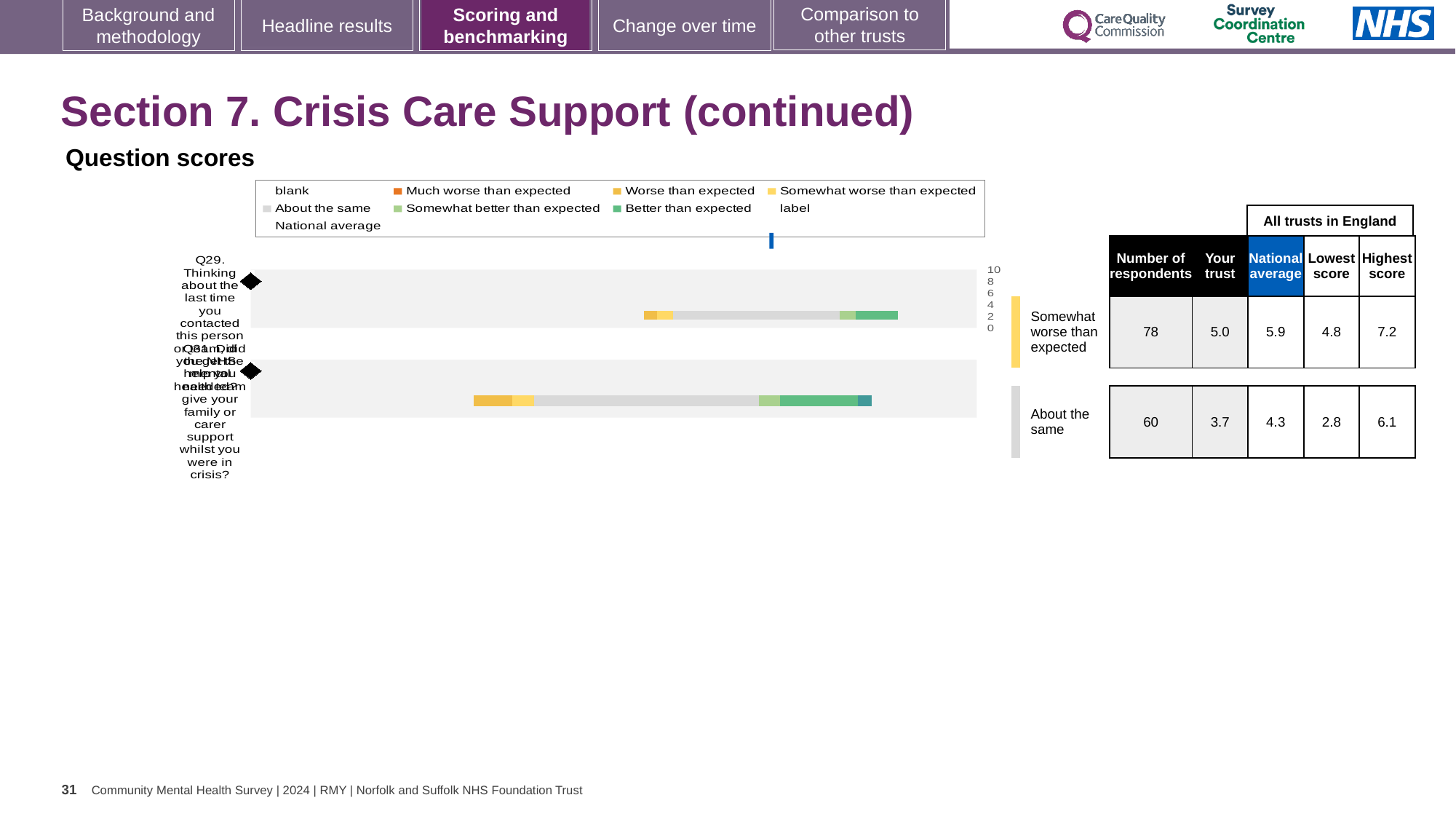
Which two question numbers are plotted in the Question scores chart? Q29 and Q31 According to the table beside the chart, what is the 'Your trust' score for the question rated 'Somewhat worse than expected'? 5.0 In the chart legend, what colour represents 'Much worse than expected'? orange What is the lowest score across all trusts in England for the question rated 'About the same'? 2.8 For the question rated 'About the same', which is larger: the 'Your trust' score or the national average? National average What kind of chart is shown under 'Question scores'? bar chart According to the table beside the chart, how many respondents answered the question rated 'Somewhat worse than expected'? 78 For the question rated 'Somewhat worse than expected', what is the difference between the national average (5.9) and the 'Your trust' score (5.0)? 0.9 How many questions (categories) are plotted in the Question scores chart? 2 According to the table beside the chart, what is the national average for the question rated 'About the same'? 4.3 Which of the two questions has the higher 'Highest score' in the table: the one rated 'Somewhat worse than expected' or the one rated 'About the same'? Somewhat worse than expected